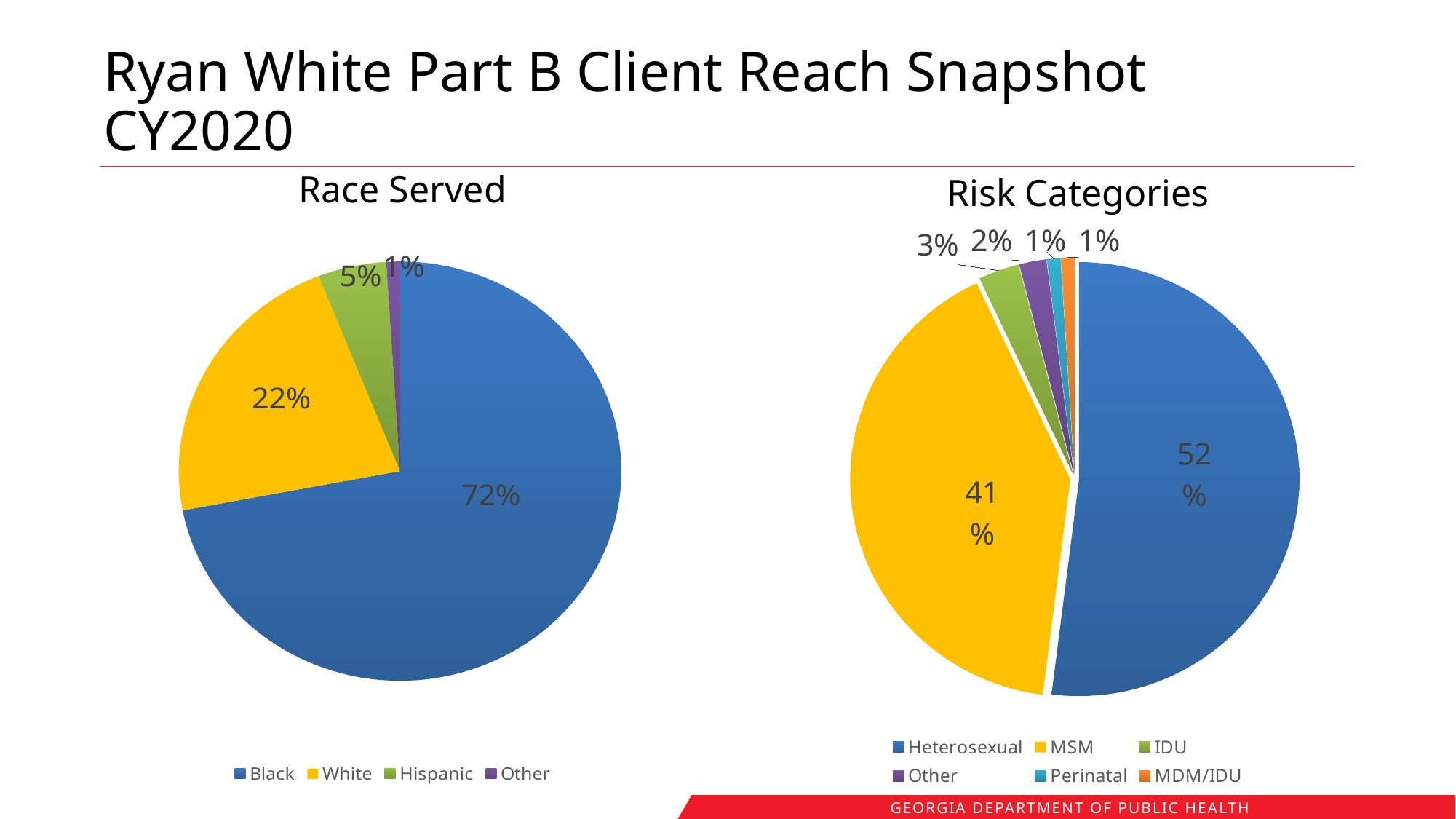
In the Risk Categories chart, what share of clients are IDU? 3% In the Race Served chart, which race category has the largest share? Black In the Race Served chart, what is the difference in percentage points between the Black and White shares? 50 In the Race Served chart, how many categories does the legend list? 4 In the Risk Categories chart, which category has the largest share? Heterosexual In the Risk Categories chart, what share of clients are MSM? 41% In the Race Served chart, what share of clients are White? 22% In the Race Served chart, what share of clients are Hispanic? 5% In the Race Served chart, which race category has the smallest share? Other What type of chart is used for Risk Categories? Pie chart In the Race Served chart, what share of clients are Black? 72% In the Risk Categories chart, what share of clients are Heterosexual? 52%